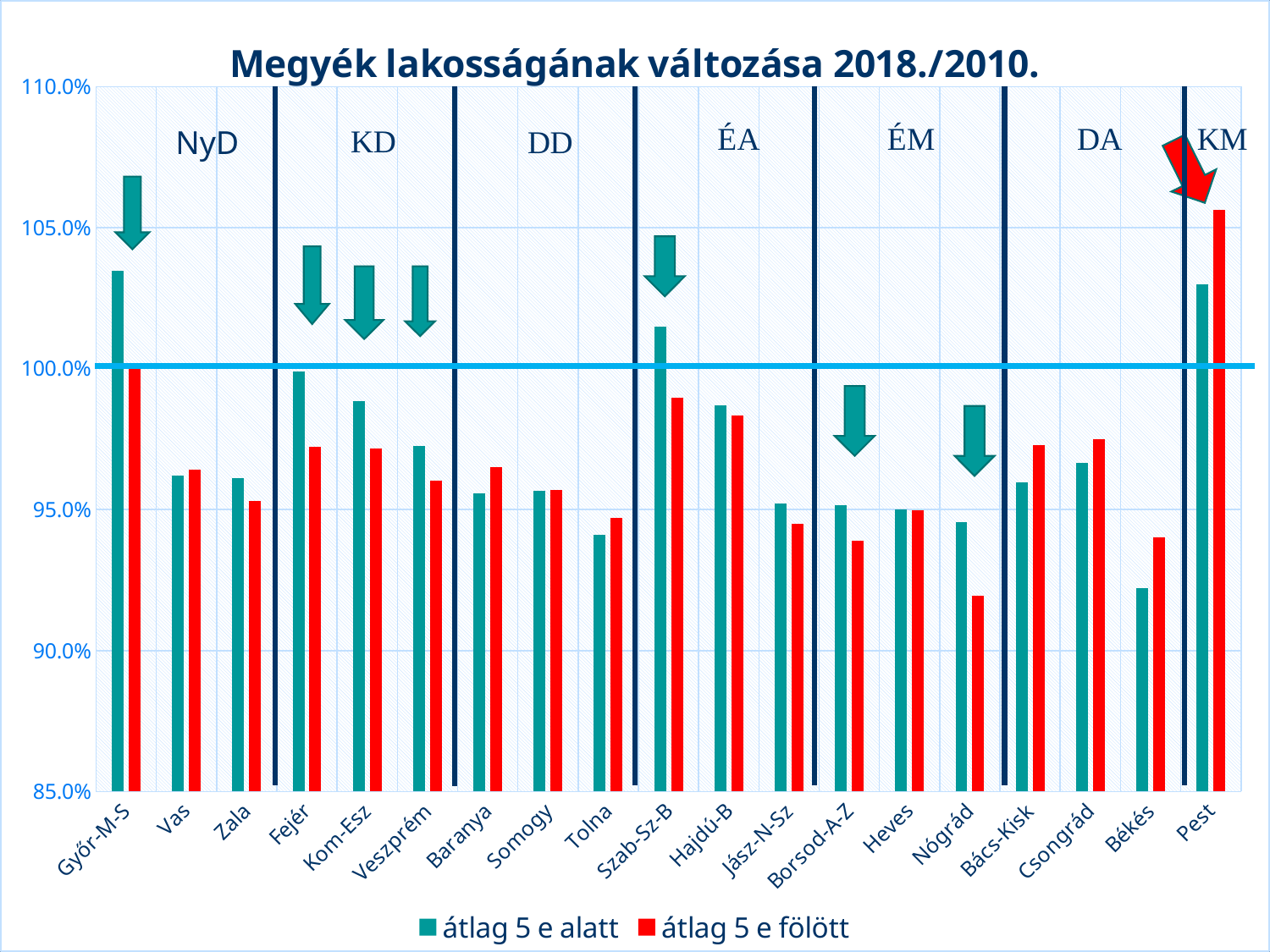
Which county has the lowest value in the 'átlag 5 e fölött' series? Nógrád What type of chart is shown on the slide? bar chart Which county has the highest value in the 'átlag 5 e fölött' series? Pest Is the 'átlag 5 e alatt' value for Győr-M-S greater or less than 100.0%? greater How many counties (categories) are shown on the x axis? 19 Is the 'átlag 5 e alatt' value for Szab-Sz-B greater or less than 100.0%? greater Is the 'átlag 5 e alatt' value for Békés greater or less than 95.0%? less For Fejér, which series has the larger value: 'átlag 5 e alatt' or 'átlag 5 e fölött'? átlag 5 e alatt What is the title of the chart? Megyék lakosságának változása 2018./2010. Which county has the lowest value in the 'átlag 5 e alatt' series? Békés How many series does the legend list? 2 For Pest, which series has the larger value: 'átlag 5 e alatt' or 'átlag 5 e fölött'? átlag 5 e fölött